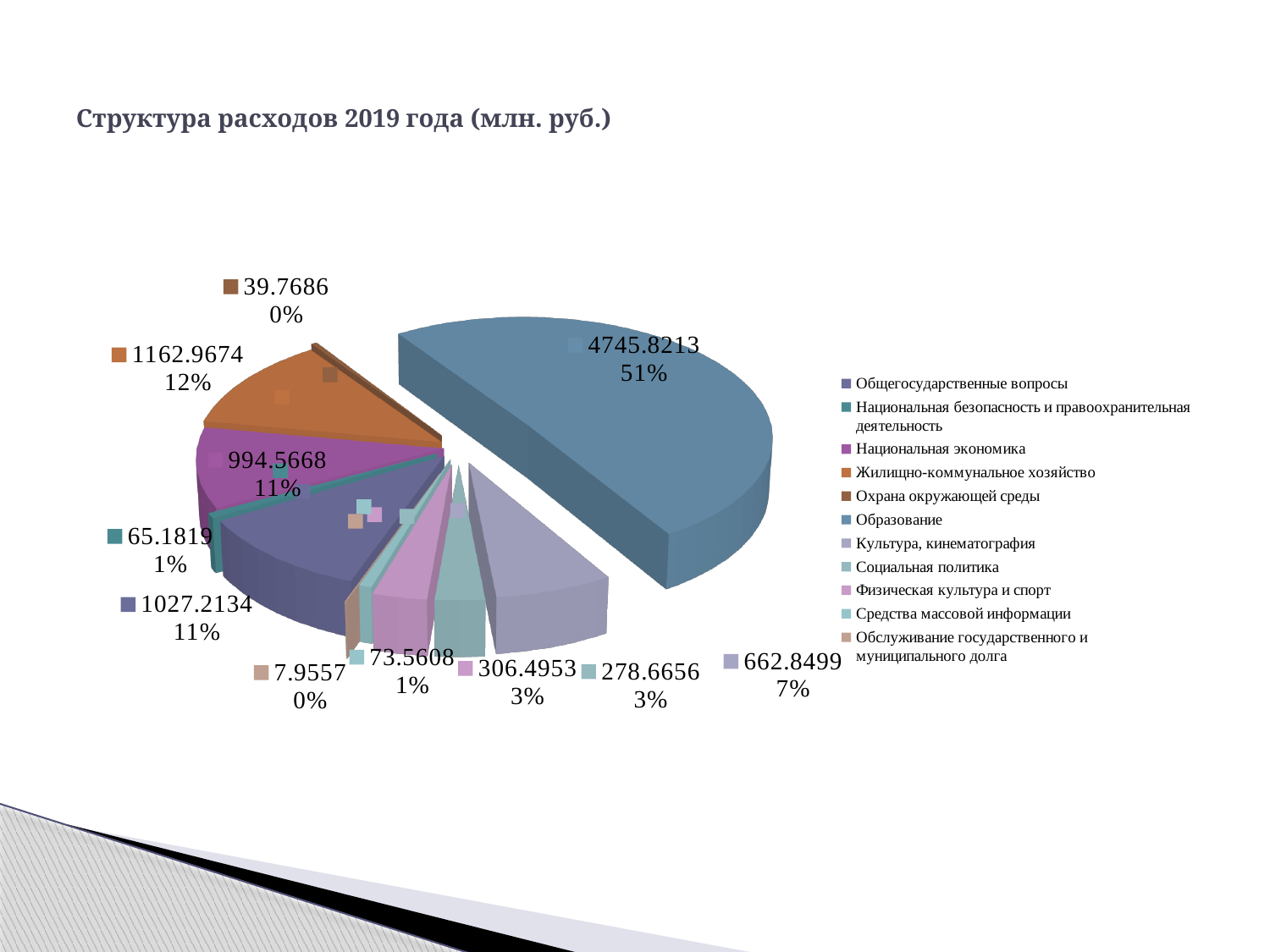
What is the value shown for Образование? 4745.8213 What is the value shown for Жилищно-коммунальное хозяйство? 1162.9674 How many categories does the legend list? 11 What percentage share of the pie does Культура, кинематография have? 7% Which is larger: the value for Жилищно-коммунальное хозяйство or the value for Общегосударственные вопросы? Жилищно-коммунальное хозяйство What percentage share of the pie does Образование have? 51% What is the value shown for Национальная безопасность и правоохранительная деятельность? 65.1819 What type of chart is shown on the slide? Pie chart Which category has the largest share of the pie? Образование What is the difference between the values for Жилищно-коммунальное хозяйство and Общегосударственные вопросы? 135.754 Which category has the smallest value in the pie chart? Обслуживание государственного и муниципального долга What is the title of the chart? Структура расходов 2019 года (млн. руб.)